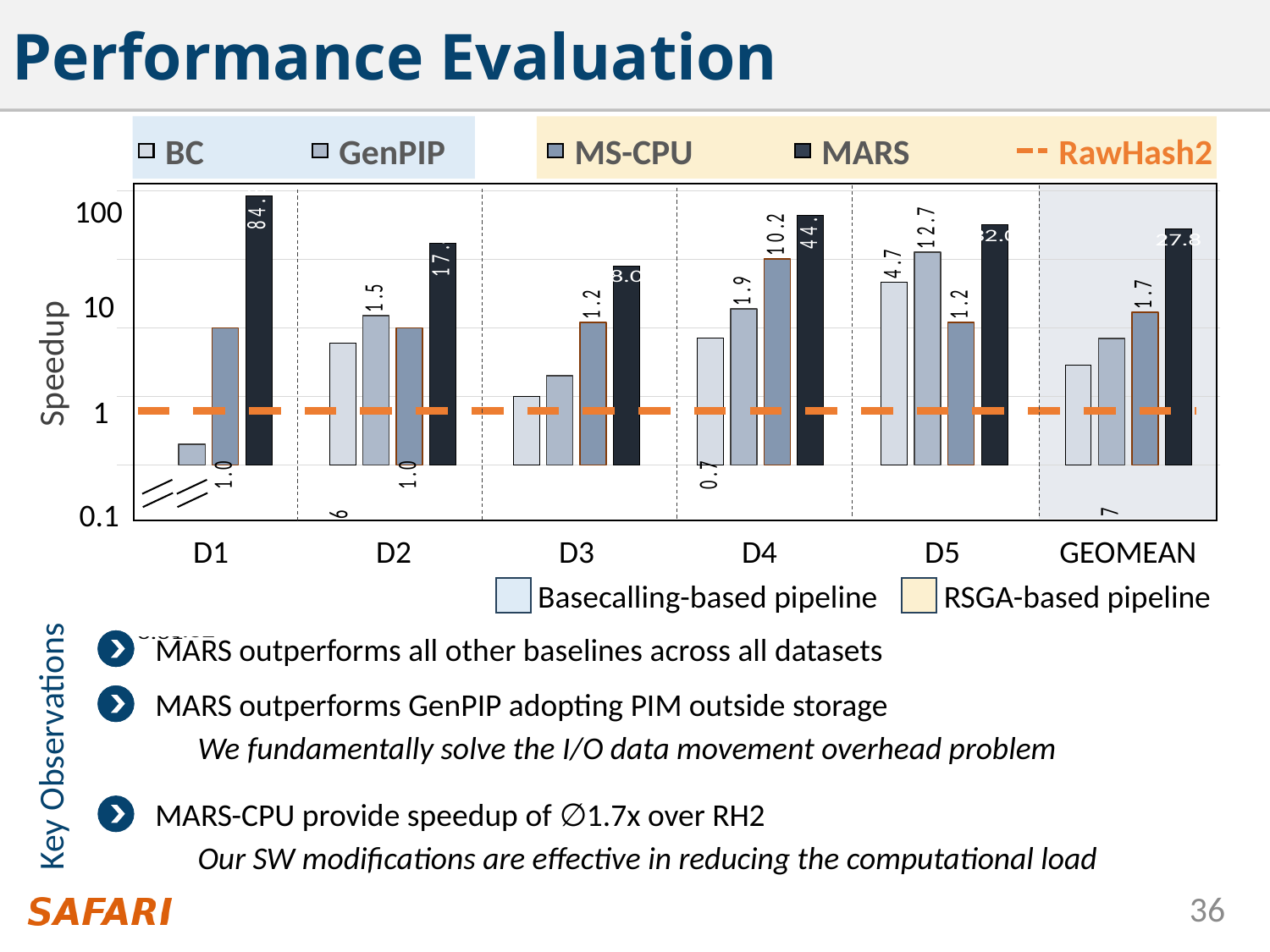
What kind of chart is shown on the slide? bar chart What is the speedup of BC for D4? 0.7 What is the speedup of MARS for GEOMEAN? 27.8 Which series has the highest speedup for D5? MARS For D5, which is larger: the speedup of BC or of GenPIP? GenPIP What is the speedup of GenPIP for D5? 12.7 What is the speedup of MS-CPU for D4? 10.2 Is the MARS speedup for D1 greater or less than 10? greater How many entries does the chart's legend list? 5 What is the speedup of MS-CPU for GEOMEAN? 1.7 For D5, what is the difference between the GenPIP speedup and the BC speedup? 8.0 How many categories are shown along the x axis of the chart? 6